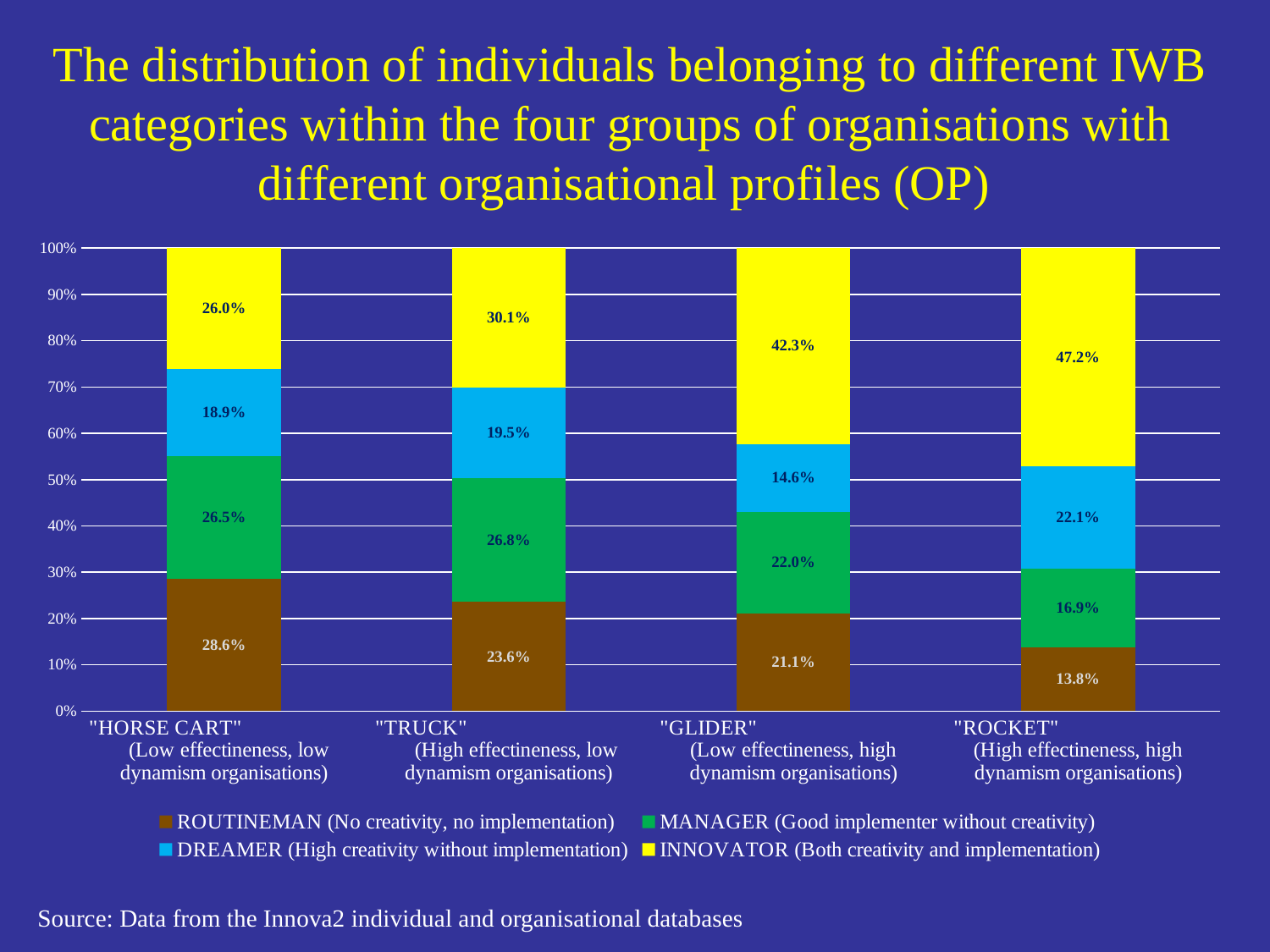
What percentage of individuals in "HORSE CART" organisations are ROUTINEMAN? 28.6% What is the DREAMER value for "GLIDER" organisations? 14.6% What is the INNOVATOR share for "ROCKET" organisations? 47.2% What is the difference between the INNOVATOR share in "ROCKET" and in "HORSE CART" organisations? 21.2% Which organisation group has the highest INNOVATOR share? "ROCKET" What is the MANAGER value for "TRUCK" organisations? 26.8% Which is larger: the DREAMER share in "TRUCK" or in "ROCKET" organisations? "ROCKET" Which organisation group has the lowest ROUTINEMAN share? "ROCKET" Which colour represents the INNOVATOR category in the chart? Yellow How many series does the legend list? 4 How many organisation groups are shown on the x axis? 4 What kind of chart is shown on the slide? Stacked bar chart